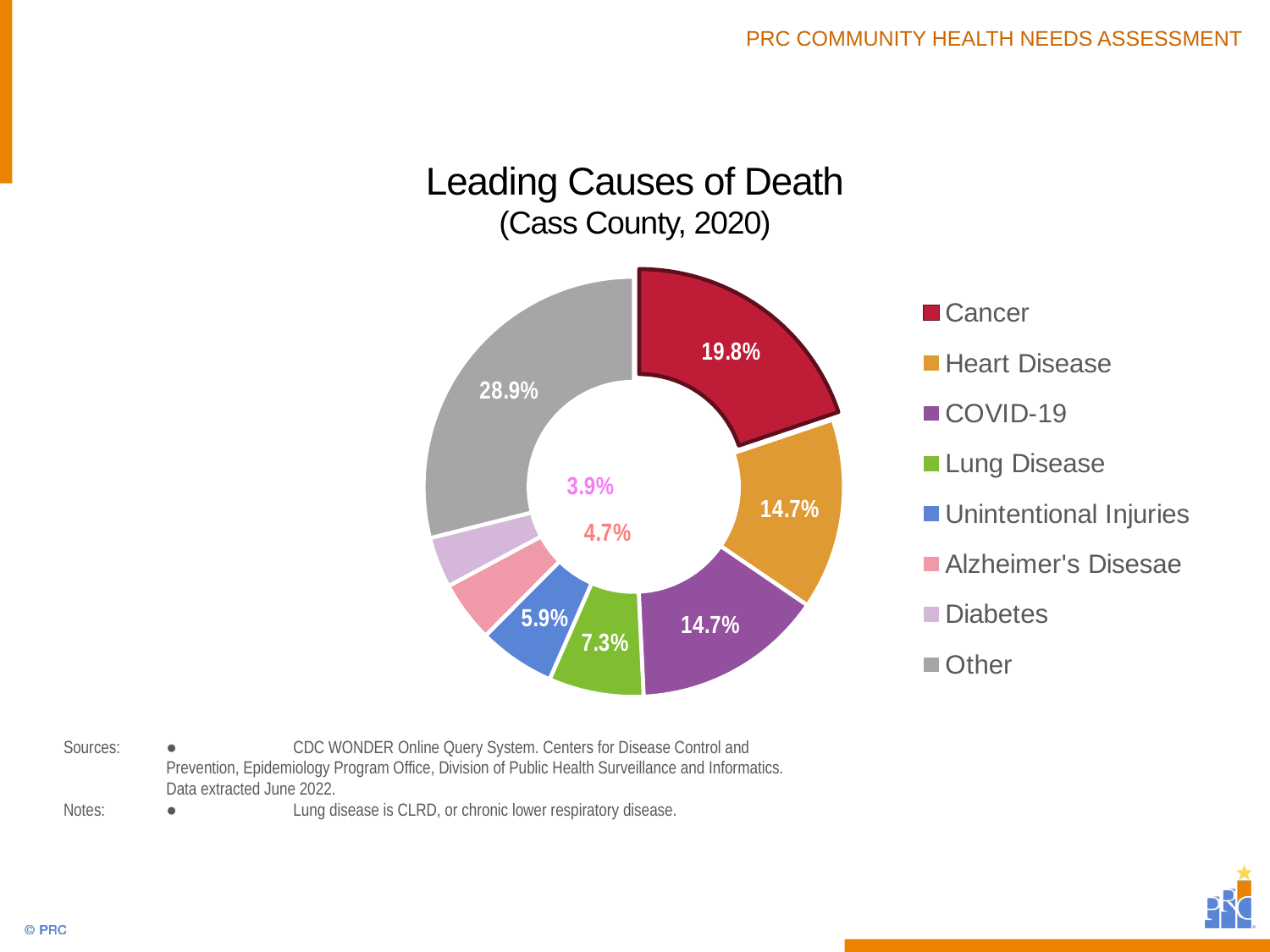
What is the title of the chart? Leading Causes of Death (Cass County, 2020) What percentage is shown for Diabetes? 3.9% What share of the pie is labelled for Lung Disease? 7.3% What colour is the Cancer slice? Red What is the value shown for Unintentional Injuries? 5.9% What kind of chart is shown on the slide? Doughnut chart Which named cause of death has the smallest slice? Diabetes What percentage of deaths is attributed to Cancer? 19.8% Which category has the largest slice of the pie? Other What is the difference between the Cancer share and the Heart Disease share? 5.1% Which is larger, the share for Lung Disease or the share for Unintentional Injuries? Lung Disease How many categories does the legend list? 8